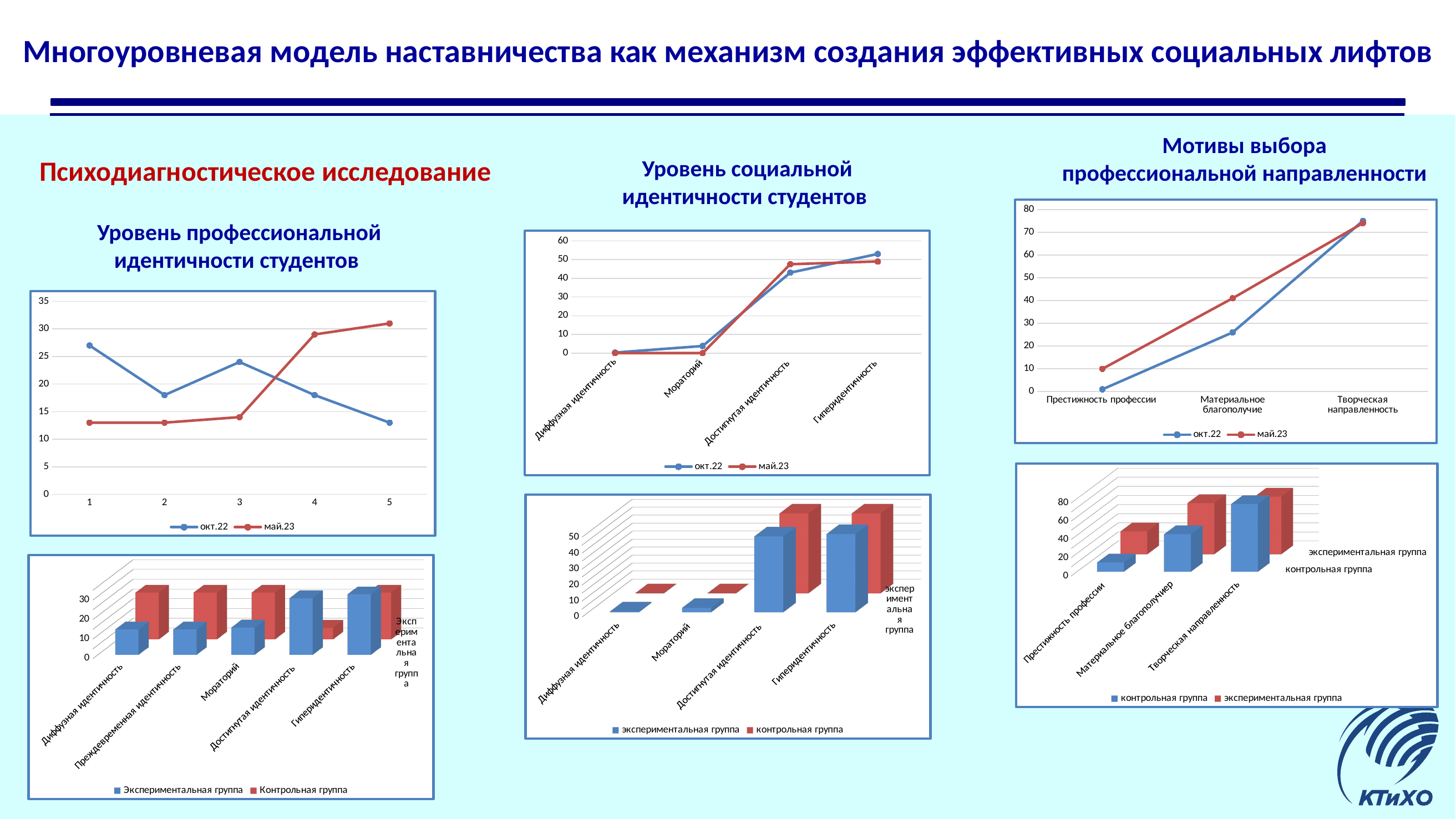
In the middle line chart 'Уровень социальной идентичности студентов', how many series does the legend list? 2 In the top-right line chart 'Мотивы выбора профессиональной направленности', do the окт.22 values rise or fall from Престижность профессии to Творческая направленность? rise In the top-left chart 'Уровень профессиональной идентичности студентов', how many points are plotted along the x axis for each series? 5 In the top-left chart 'Уровень профессиональной идентичности студентов', at which category is the май.23 series highest? 5 In the top-left chart 'Уровень профессиональной идентичности студентов', is the окт.22 value at category 1 greater or less than 25? greater How many categories are shown in the bottom-left 3D bar chart? 5 In the middle line chart 'Уровень социальной идентичности студентов', is the май.23 value for Достигнутая идентичность greater or less than 40? greater In the middle line chart 'Уровень социальной идентичности студентов', which category has the highest окт.22 value? Гиперидентичность In the top-right line chart 'Мотивы выбора профессиональной направленности', which series has the larger value for Престижность профессии, окт.22 or май.23? май.23 In the top-left chart 'Уровень профессиональной идентичности студентов', at which category is the окт.22 series lowest? 5 What are the two legend entries of the bottom-right 3D bar chart? контрольная группа, экспериментальная группа What kind of chart is the top-left chart titled 'Уровень профессиональной идентичности студентов'? line chart